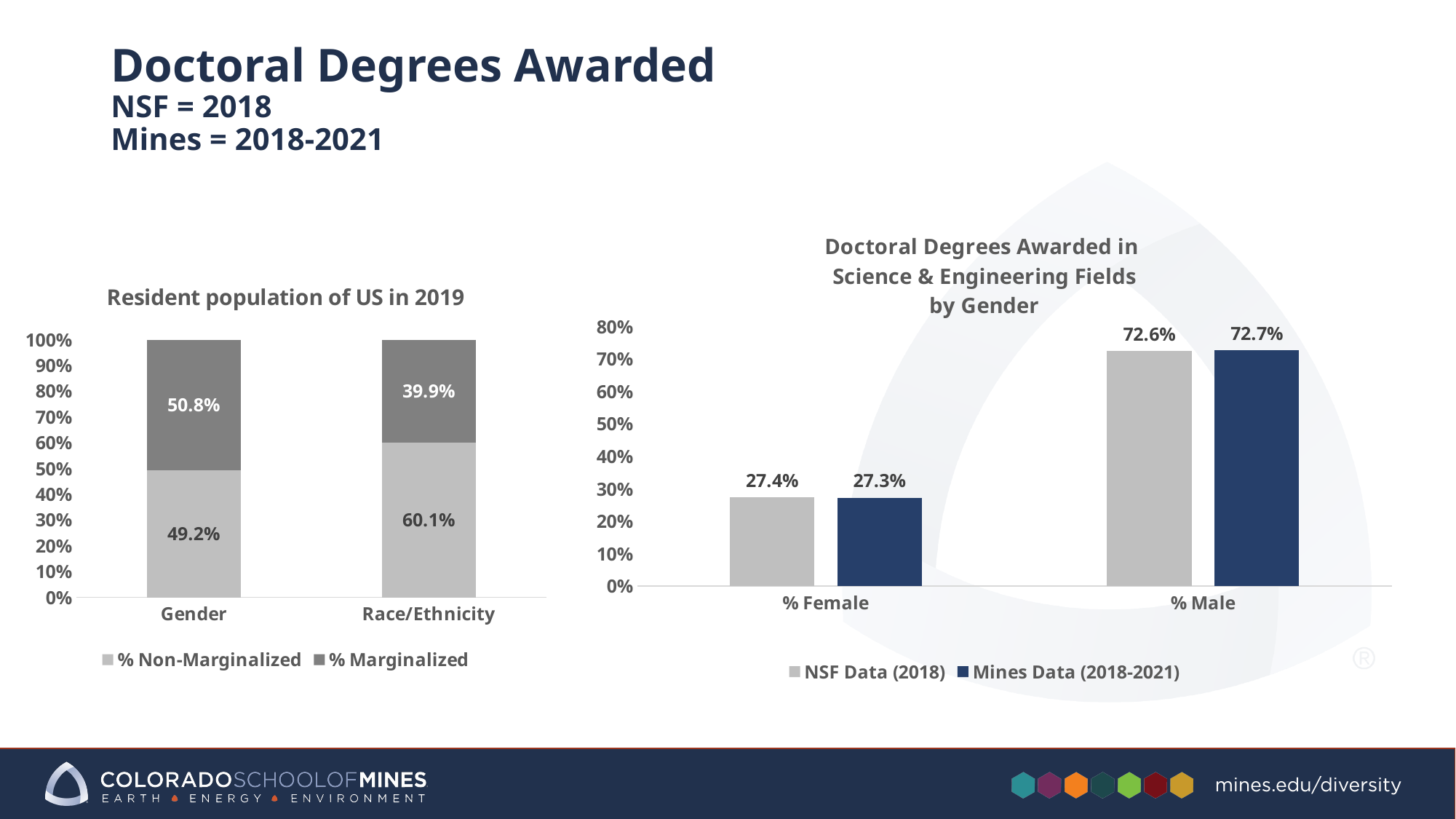
In the 'Doctoral Degrees Awarded in Science & Engineering Fields by Gender' chart, how many categories are shown on the x axis? 2 In the 'Doctoral Degrees Awarded in Science & Engineering Fields by Gender' chart, what is the NSF Data (2018) value for % Female? 27.4% In the 'Resident population of US in 2019' chart, which category has the higher % Marginalized value? Gender In the 'Resident population of US in 2019' chart, how many series does the legend list? 2 In the 'Resident population of US in 2019' chart, what is the % Non-Marginalized value for Race/Ethnicity? 60.1% In the 'Resident population of US in 2019' chart, what is the difference between the % Non-Marginalized values for Race/Ethnicity and Gender? 10.9% In the 'Doctoral Degrees Awarded in Science & Engineering Fields by Gender' chart, what is the Mines Data (2018-2021) value for % Male? 72.7% In the 'Doctoral Degrees Awarded in Science & Engineering Fields by Gender' chart, which category has the lowest NSF Data (2018) value? % Female In the 'Resident population of US in 2019' chart, what is the total of the stacked bar for Race/Ethnicity? 100% What kind of chart is the 'Doctoral Degrees Awarded in Science & Engineering Fields by Gender' chart? Bar chart In the 'Resident population of US in 2019' chart, what is the % Marginalized value for Gender? 50.8% In the 'Doctoral Degrees Awarded in Science & Engineering Fields by Gender' chart, what is the difference between the Mines Data (2018-2021) values for % Male and % Female? 45.4%